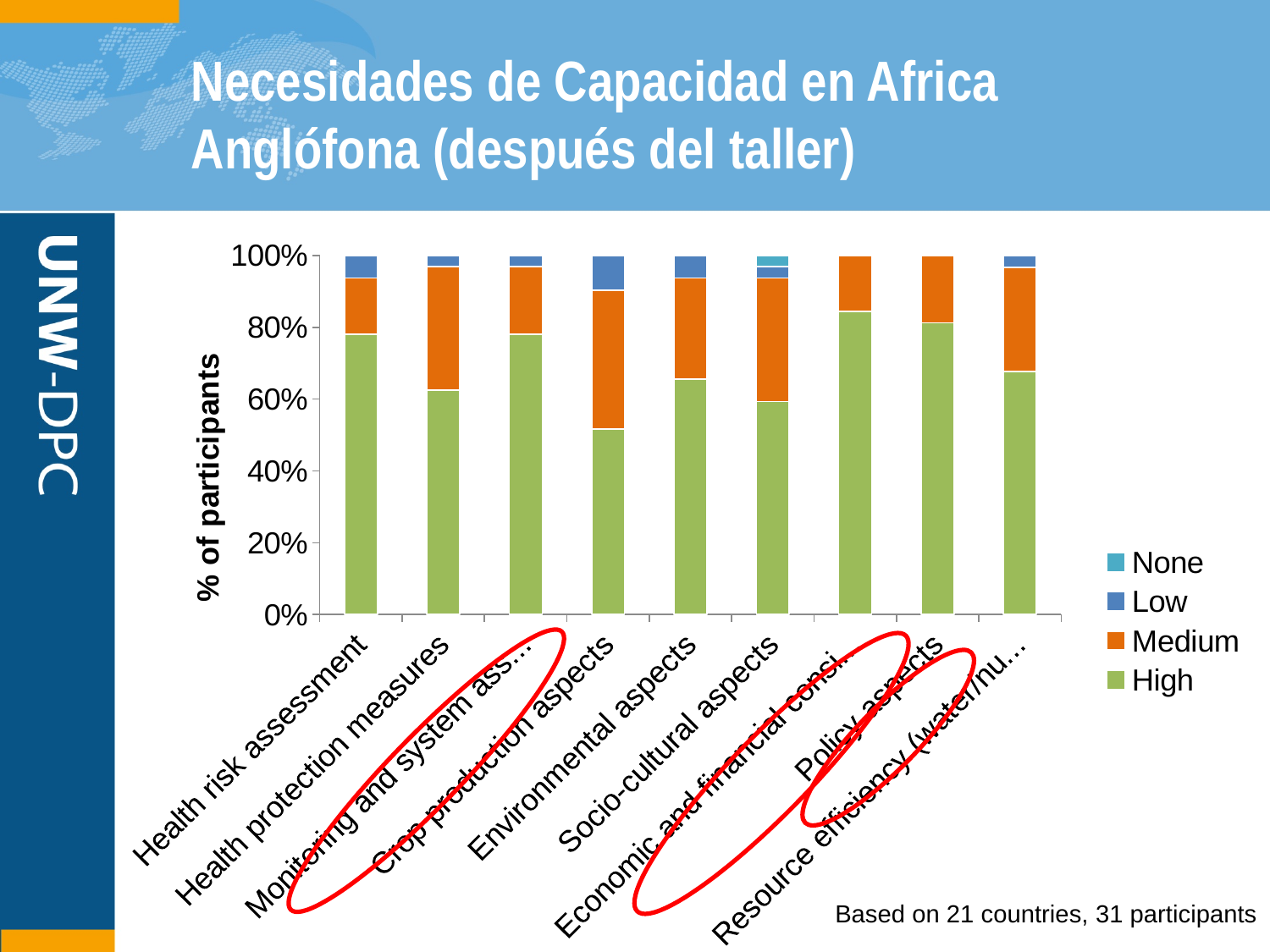
What is the label of the y axis? % of participants Which category is the only one with a visible None segment? Socio-cultural aspects Is the High share for Crop production aspects greater or less than 60%? less How many series does the legend list? 4 Which category has the lowest High share? Crop production aspects Which has the larger High share, Crop production aspects or Environmental aspects? Environmental aspects What kind of chart is shown on the slide? Stacked bar chart Is the High share for Policy aspects greater or less than 60%? greater Is the Medium share for Crop production aspects greater or less than 20%? greater Which has the larger High share, Health risk assessment or Health protection measures? Health risk assessment How many categories are plotted along the x axis? 9